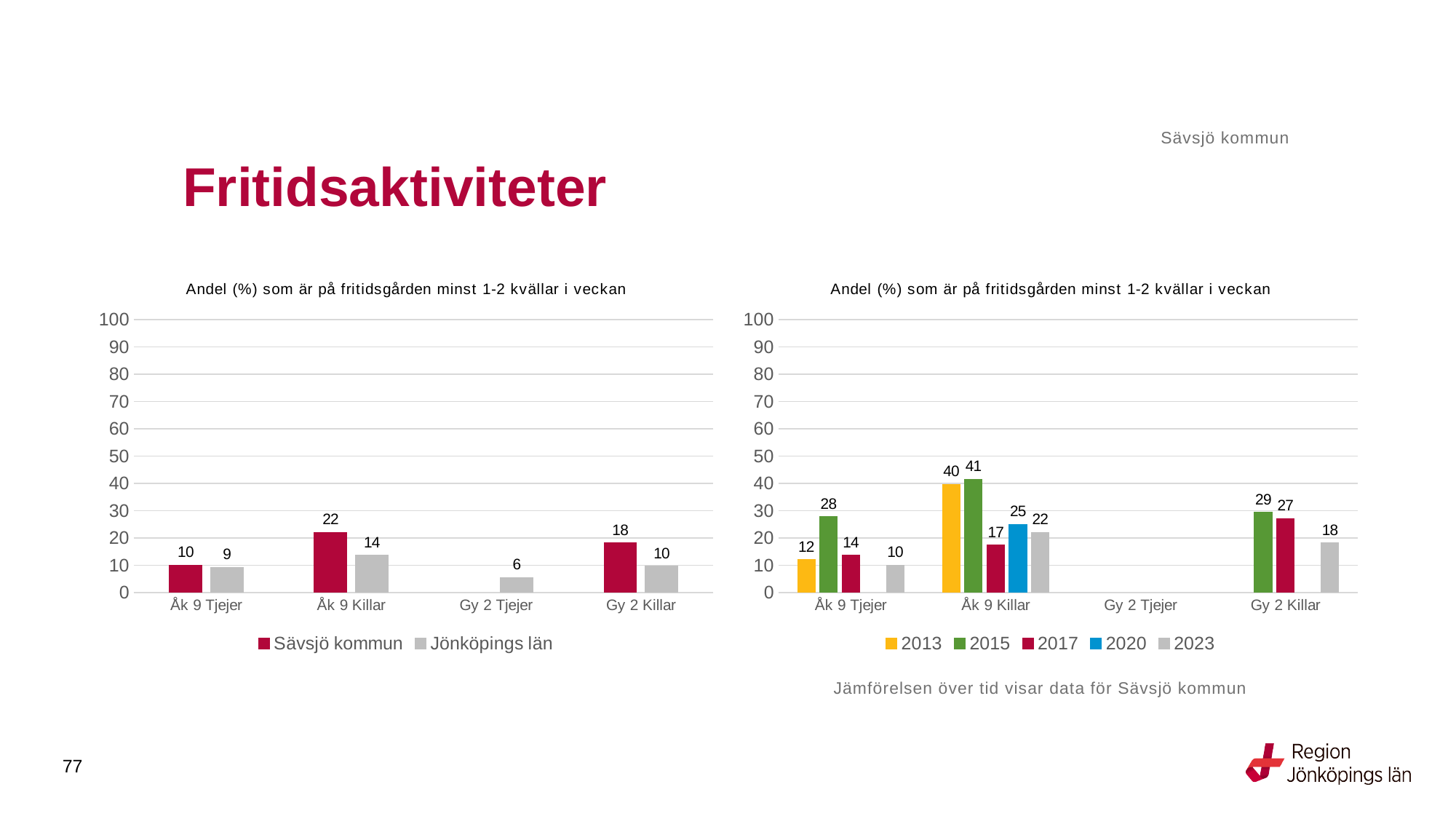
In the left chart, which category has the highest value for Jönköpings län? Åk 9 Killar In the right chart, which year has the lowest value for Åk 9 Tjejer? 2023 In the right chart, is the 2015 value for Gy 2 Killar larger or smaller than the 2017 value? larger What kind of chart is the right chart? Bar chart In the right chart, what is the difference between the 2013 and 2017 values for Åk 9 Killar? 23 In the left chart, what is the value for Jönköpings län for Gy 2 Tjejer? 6 In the right chart, how many series does the legend list? 5 In the left chart, how many series does the legend list? 2 In the right chart, what is the value for 2015 for Åk 9 Killar? 41 In the left chart, what is the difference between Sävsjö kommun and Jönköpings län for Gy 2 Killar? 8 In the left chart, what is the value for Sävsjö kommun for Åk 9 Killar? 22 In the right chart, what is the value for 2023 for Gy 2 Killar? 18